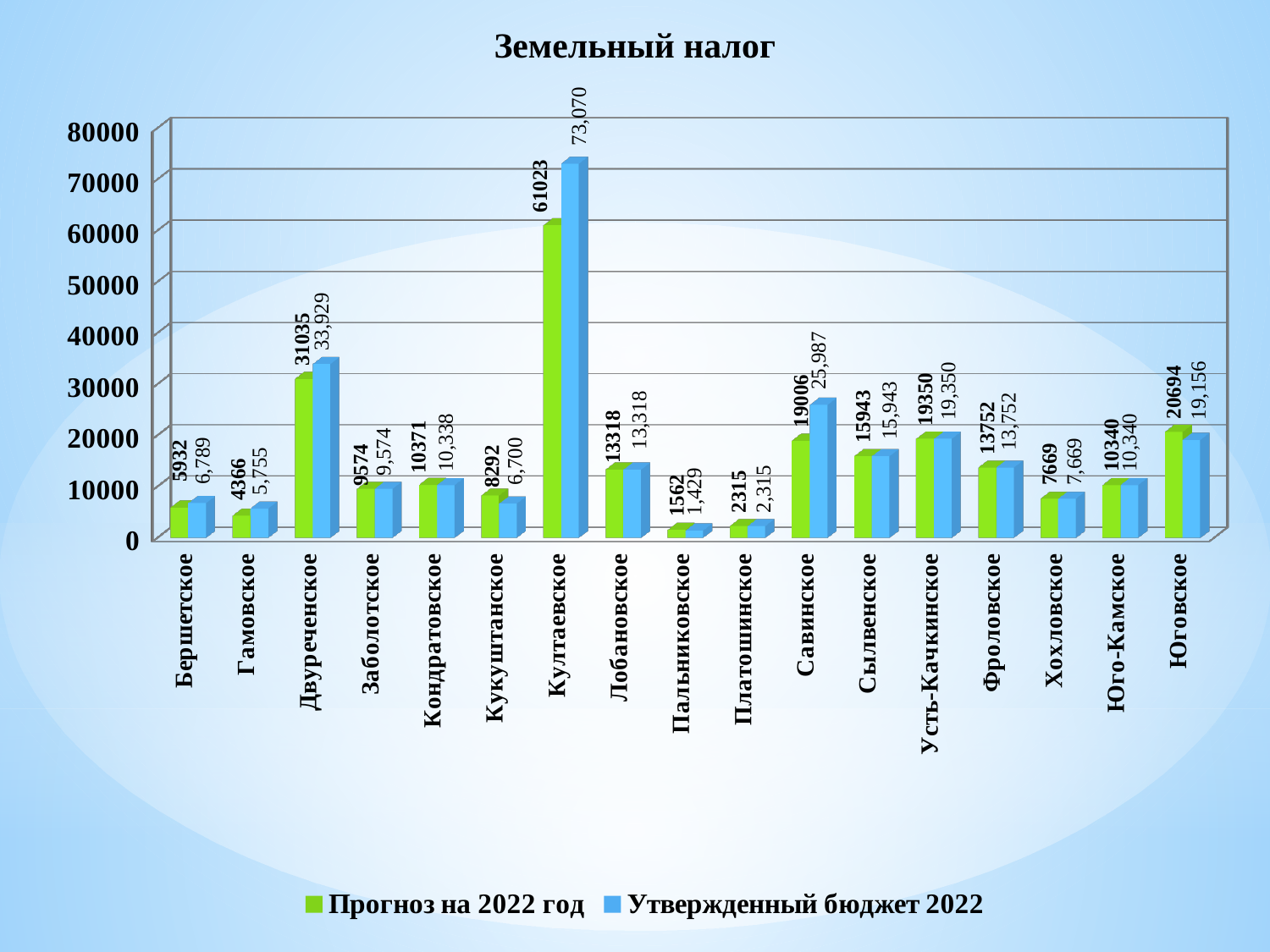
Is the value of 'Утвержденный бюджет 2022' for Двуреченское greater or less than 30000? greater Which category has the lowest value for 'Прогноз на 2022 год'? Пальниковское What is the value of 'Прогноз на 2022 год' for Юговское? 20694 What is the value of 'Утвержденный бюджет 2022' for Савинское? 25,987 Which is larger for Кукуштанское: 'Прогноз на 2022 год' or 'Утвержденный бюджет 2022'? Прогноз на 2022 год Which category has the highest value for 'Утвержденный бюджет 2022'? Култаевское What is the value of 'Прогноз на 2022 год' for Култаевское? 61023 How many categories are shown on the x axis? 17 What is the title of the chart? Земельный налог What type of chart is shown on the slide? bar chart What is the difference between 'Утвержденный бюджет 2022' and 'Прогноз на 2022 год' for Култаевское? 12047 How many series does the legend list? 2